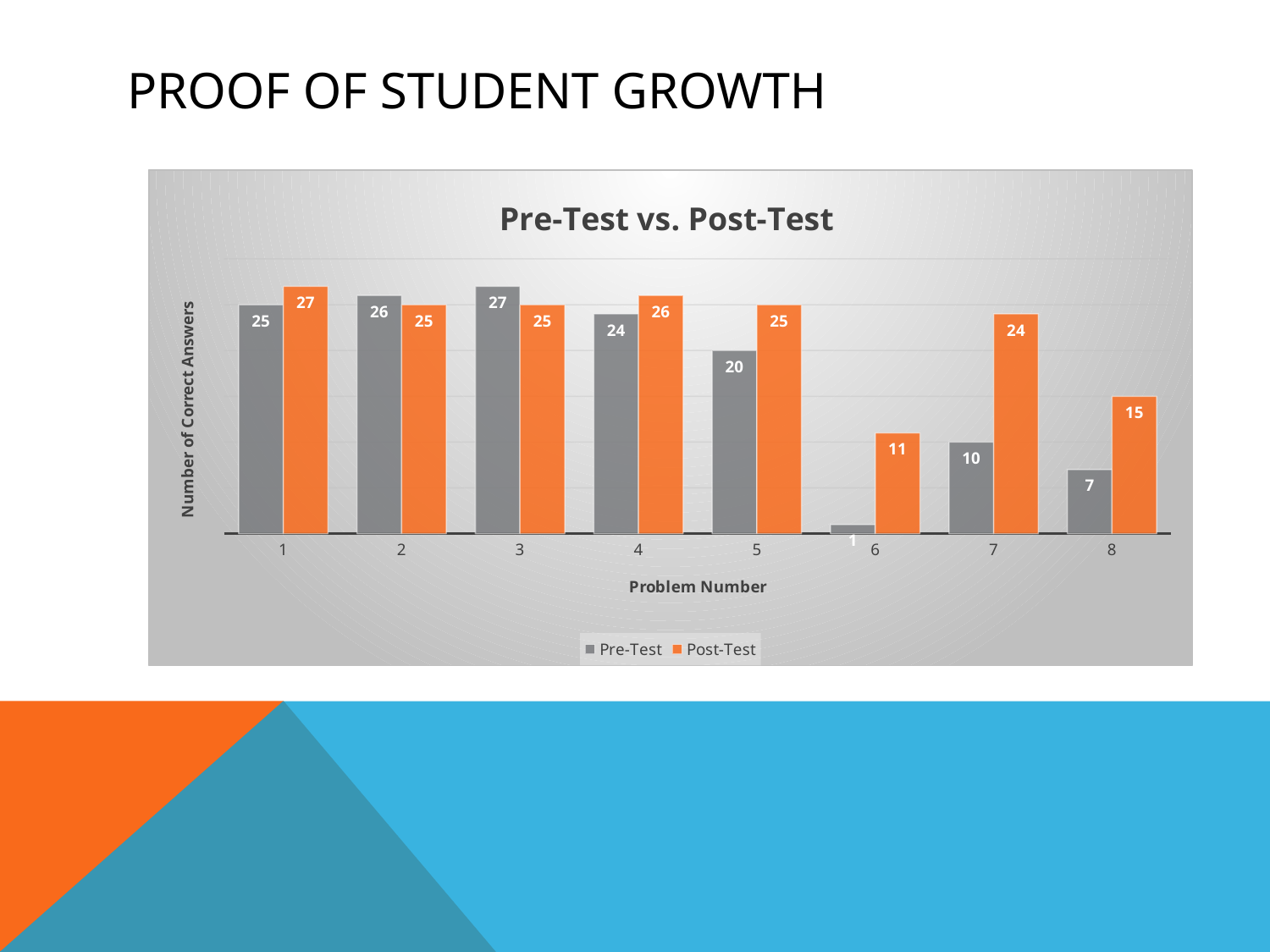
What is the title of the chart? Pre-Test vs. Post-Test Which is larger for problem 3, the Pre-Test value or the Post-Test value? Pre-Test What is the Pre-Test value for problem 6? 1 What is the Post-Test value for problem 7? 24 How many problem numbers are shown on the x axis? 8 What kind of chart is shown on the slide? Bar chart Which problem number has the highest Pre-Test value? 3 Which problem number has the lowest Post-Test value? 6 What is the Pre-Test value for problem 5? 20 What is the difference between the Post-Test and Pre-Test values for problem 7? 14 How many series does the legend list? 2 What colour are the Post-Test bars? Orange